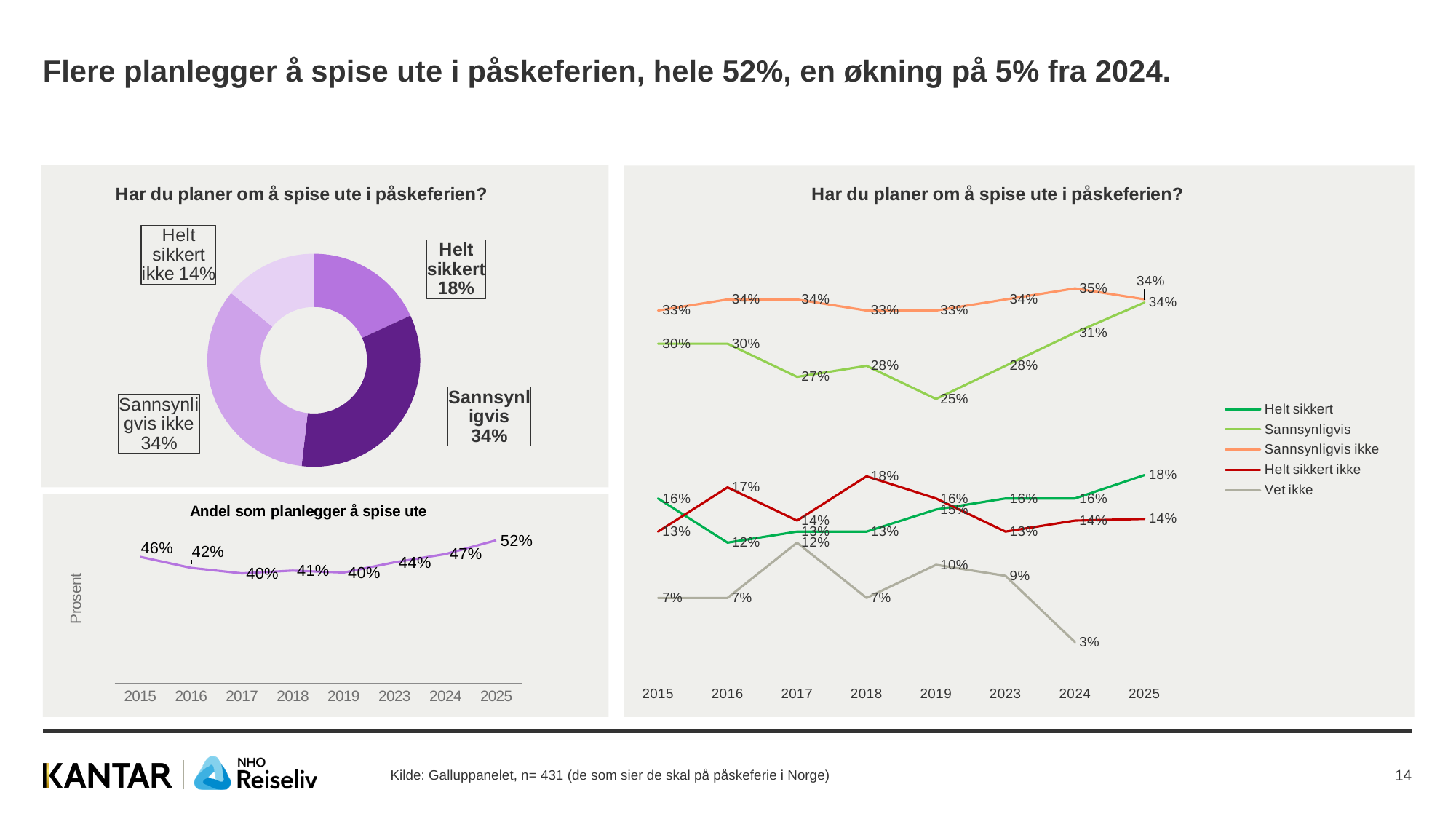
In the line chart on the right, what is the value for 'Vet ikke' in 2024? 3% In the line chart on the right, what is the value for 'Sannsynligvis' in 2019? 25% In the line chart on the right, how many series does the legend list? 5 What type of chart is 'Andel som planlegger å spise ute'? Line chart In the chart 'Andel som planlegger å spise ute', which year has the lowest value? 2017 and 2019 (40%) In the chart 'Andel som planlegger å spise ute', what is the value for 2025? 52% In the chart 'Andel som planlegger å spise ute', how many years are shown on the x axis? 8 In the donut chart on the top left, what share is 'Helt sikkert ikke'? 14% In the donut chart on the top left, which category has the smallest share? Helt sikkert ikke In the chart 'Andel som planlegger å spise ute', what is the difference between the 2025 and 2024 values? 5% In the line chart on the right, which is larger in 2016: 'Helt sikkert' or 'Helt sikkert ikke'? Helt sikkert ikke In the donut chart on the top left, what share is 'Helt sikkert'? 18%